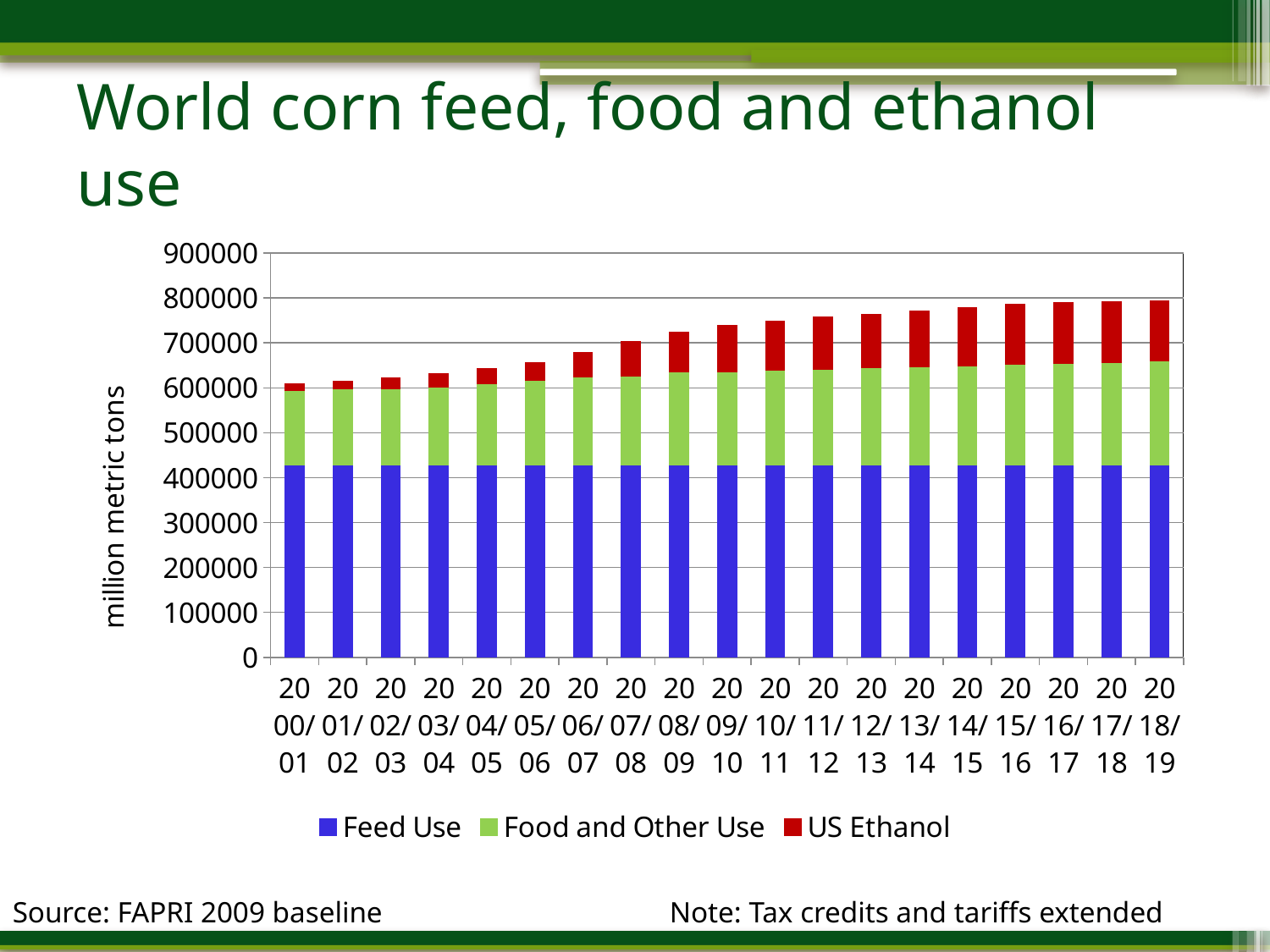
What kind of chart is shown on the slide? stacked bar chart Does the total height of the stacked bars rise or fall from 2000/01 to 2018/19? rise Which is larger, the US Ethanol segment in 2018/19 or in 2000/01? 2018/19 What is the label on the vertical axis? million metric tons Is the total stacked value for 2018/19 greater or less than 700000? greater Is the Feed Use value for 2010/11 greater or less than 400000? greater In 2018/19, which segment is larger, Feed Use or US Ethanol? Feed Use Which year has the lowest total stacked bar? 2000/01 How many marketing years (categories) are plotted on the x axis? 19 How many series does the legend list? 3 Which series are listed in the legend? Feed Use, Food and Other Use, US Ethanol Is the total stacked value for 2000/01 greater or less than 700000? less